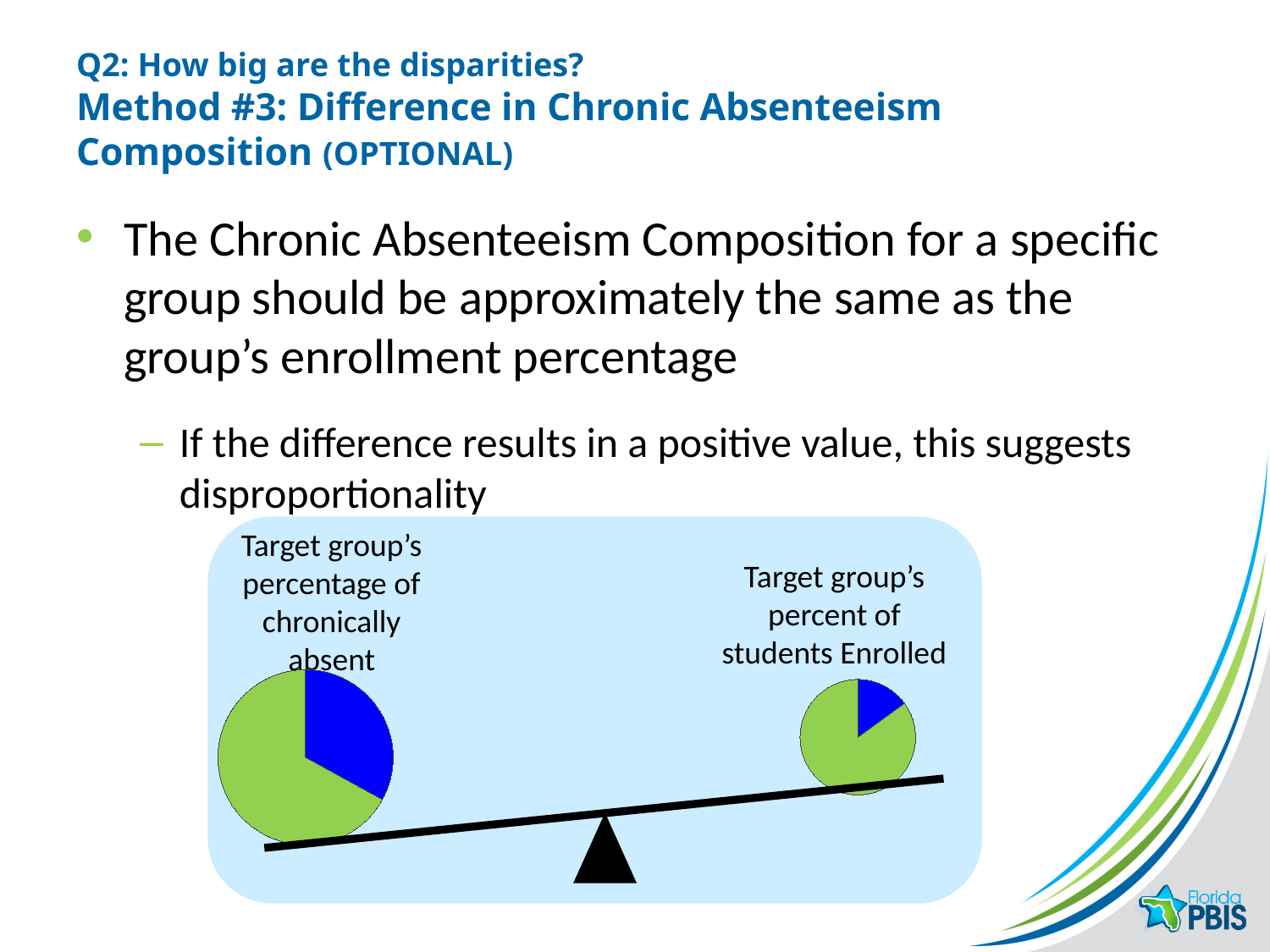
How many pie charts are shown on the slide? 2 What kind of chart is used on the left side of the balance, labelled "Target group's percentage of chronically absent"? Pie chart In the right pie chart (Target group's percent of students Enrolled), which colour slice is the smallest? Blue How many slices does the right pie chart (Target group's percent of students Enrolled) have? 2 In the left pie chart (Target group's percentage of chronically absent), is the blue slice larger or smaller than the green slice? Smaller What kind of chart is used on the right side of the balance, labelled "Target group's percent of students Enrolled"? Pie chart How many slices does the left pie chart (Target group's percentage of chronically absent) have? 2 In the left pie chart (Target group's percentage of chronically absent), which colour slice is the largest? Green Is the blue slice larger in the left pie chart (percentage of chronically absent) or in the right pie chart (percent of students Enrolled)? Left pie chart (percentage of chronically absent) What is the label above the pie chart on the right side of the balance? Target group's percent of students Enrolled What is the label above the pie chart on the left side of the balance? Target group's percentage of chronically absent